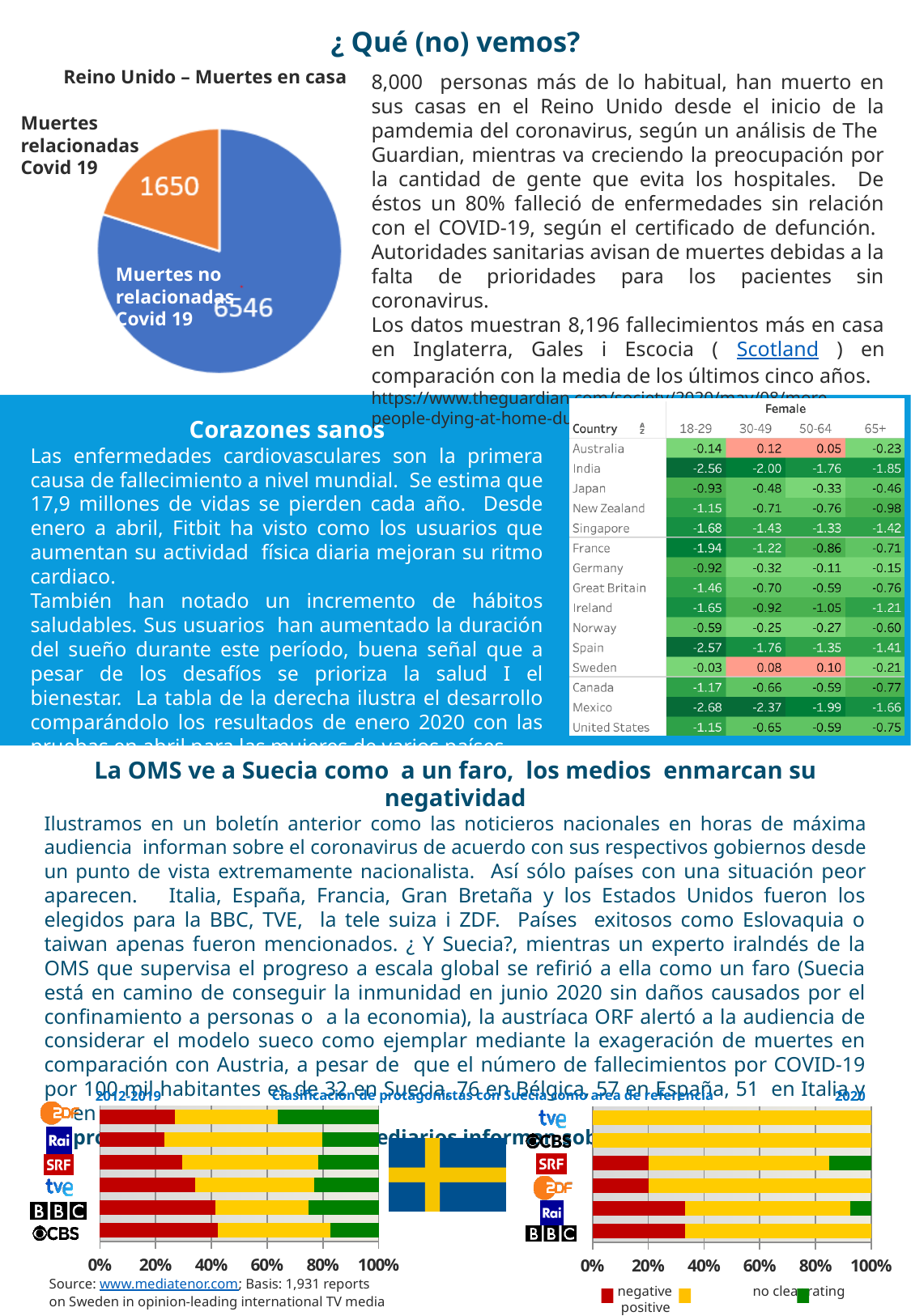
How many slices does the chart 'Reino Unido – Muertes en casa' have? 2 How many series does the legend of the bottom media-rating bar charts list? 3 In the chart 'Reino Unido – Muertes en casa', what is the total of the two slices? 8196 In the chart 'Reino Unido – Muertes en casa', what is the difference between the two slices? 4896 In the chart 'Reino Unido – Muertes en casa', which category has the largest value? Muertes no relacionadas Covid 19 In the chart 'Reino Unido – Muertes en casa', what is the value for 'Muertes no relacionadas Covid 19'? 6546 What kind of chart is 'Reino Unido – Muertes en casa'? Pie chart In the bottom-right bar chart (2020), is the negative share for tve greater or less than 40%? less In the bottom-left bar chart (2012-2019), how many broadcasters are shown? 6 In the chart 'Reino Unido – Muertes en casa', what is the value for 'Muertes relacionadas Covid 19'? 1650 In the chart 'Reino Unido – Muertes en casa', which category has the smallest value? Muertes relacionadas Covid 19 What kind of chart is used at the bottom of the slide for the media ratings of Sweden (2012-2019 and 2020)? Bar chart